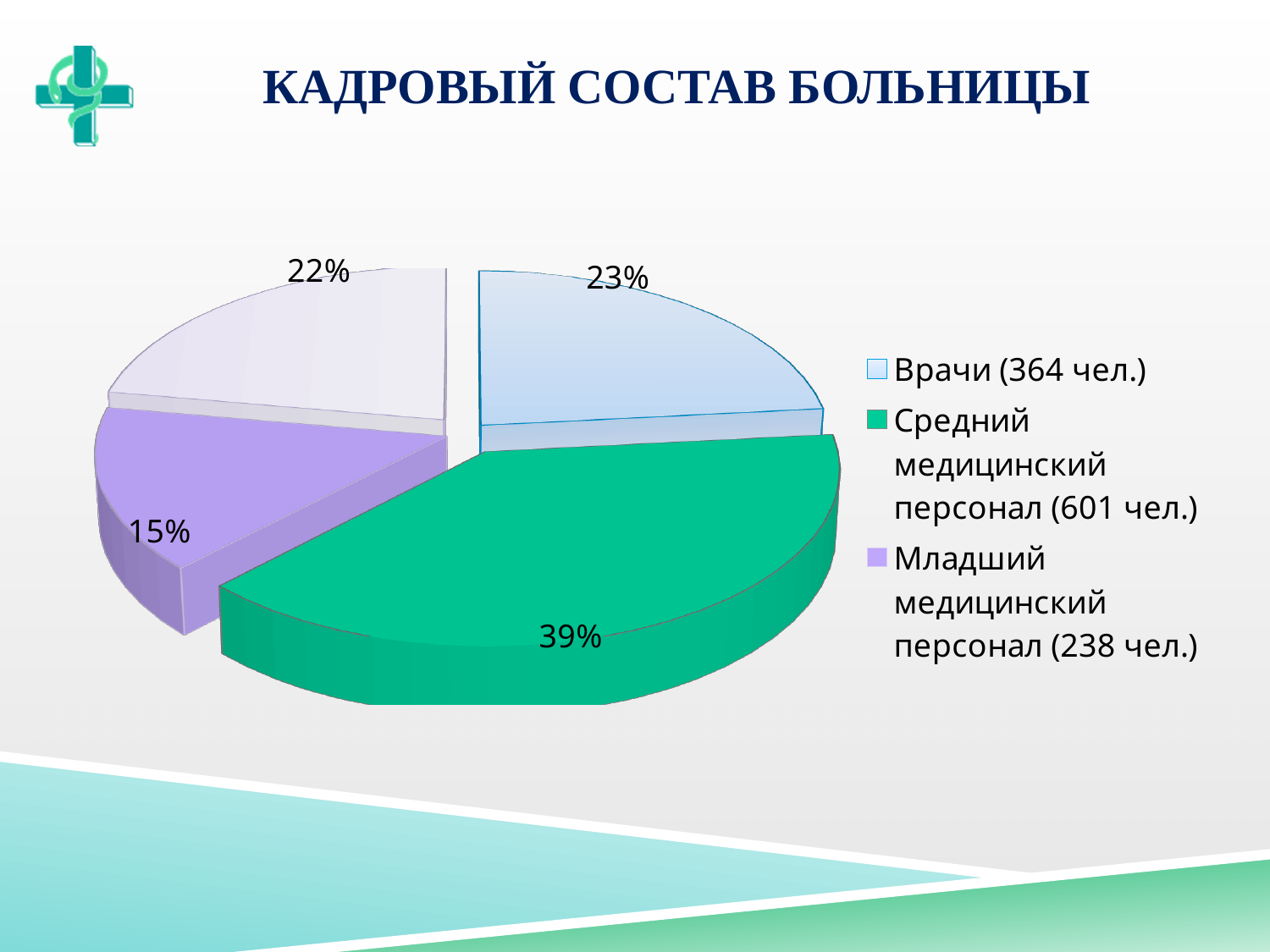
How many slices does the pie chart have? 4 What is the difference in percentage points between the Средний медицинский персонал slice and the Врачи slice? 16% Which legend category has the largest slice of the pie? Средний медицинский персонал (601 чел.) What share of the pie does the slice for Врачи (364 чел.) represent? 23% What share of the pie does the slice for Младший медицинский персонал (238 чел.) represent? 15% What is the title of the slide? КАДРОВЫЙ СОСТАВ БОЛЬНИЦЫ Which slice of the pie is the smallest? Младший медицинский персонал (238 чел.) How many entries does the legend list? 3 What share of the pie does the slice for Средний медицинский персонал (601 чел.) represent? 39% What colour is the slice for Средний медицинский персонал? green Which is larger: the slice for Врачи or the slice for Младший медицинский персонал? Врачи What kind of chart is shown on the slide? pie chart